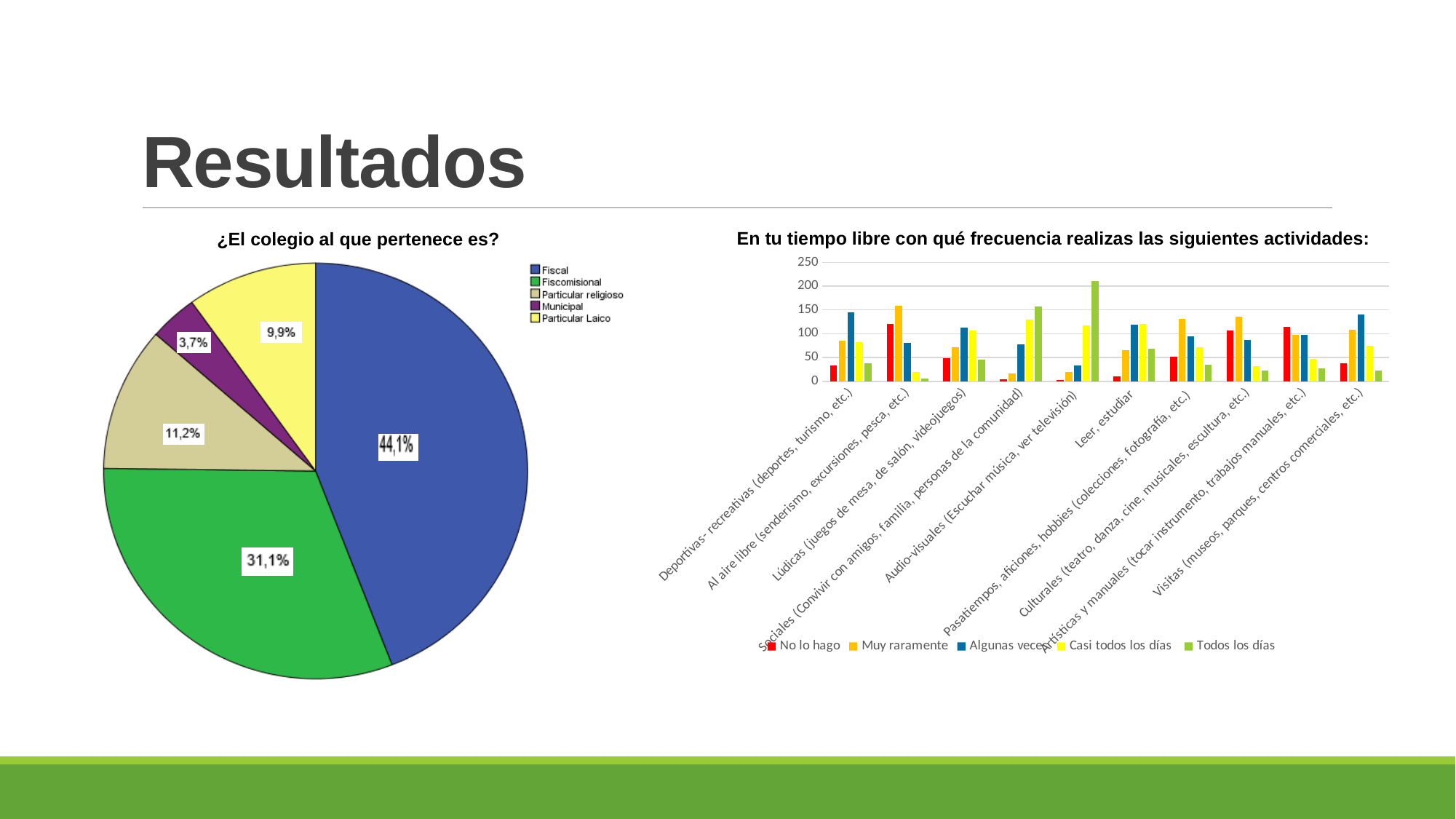
In the pie chart '¿El colegio al que pertenece es?', what percentage is shown for Fiscal? 44,1% In the pie chart '¿El colegio al que pertenece es?', what is the difference in percentage points between Fiscal and Fiscomisional? 13,0 In the pie chart '¿El colegio al que pertenece es?', which is larger: Particular religioso or Particular Laico? Particular religioso In the pie chart '¿El colegio al que pertenece es?', which category has the largest slice? Fiscal In the chart 'En tu tiempo libre con qué frecuencia realizas las siguientes actividades:', is the value for 'No lo hago' in the Audio-visuales category greater or less than 50? less How many categories does the legend of the pie chart '¿El colegio al que pertenece es?' list? 5 What kind of chart is the chart on the left of the slide? Pie chart In the chart 'En tu tiempo libre con qué frecuencia realizas las siguientes actividades:', is the value for 'Todos los días' in the Audio-visuales category greater or less than 200? greater How many series does the legend of the chart 'En tu tiempo libre con qué frecuencia realizas las siguientes actividades:' list? 5 In the pie chart '¿El colegio al que pertenece es?', what percentage is shown for Fiscomisional? 31,1% In the pie chart '¿El colegio al que pertenece es?', which category has the smallest slice? Municipal What kind of chart is 'En tu tiempo libre con qué frecuencia realizas las siguientes actividades:'? Bar chart